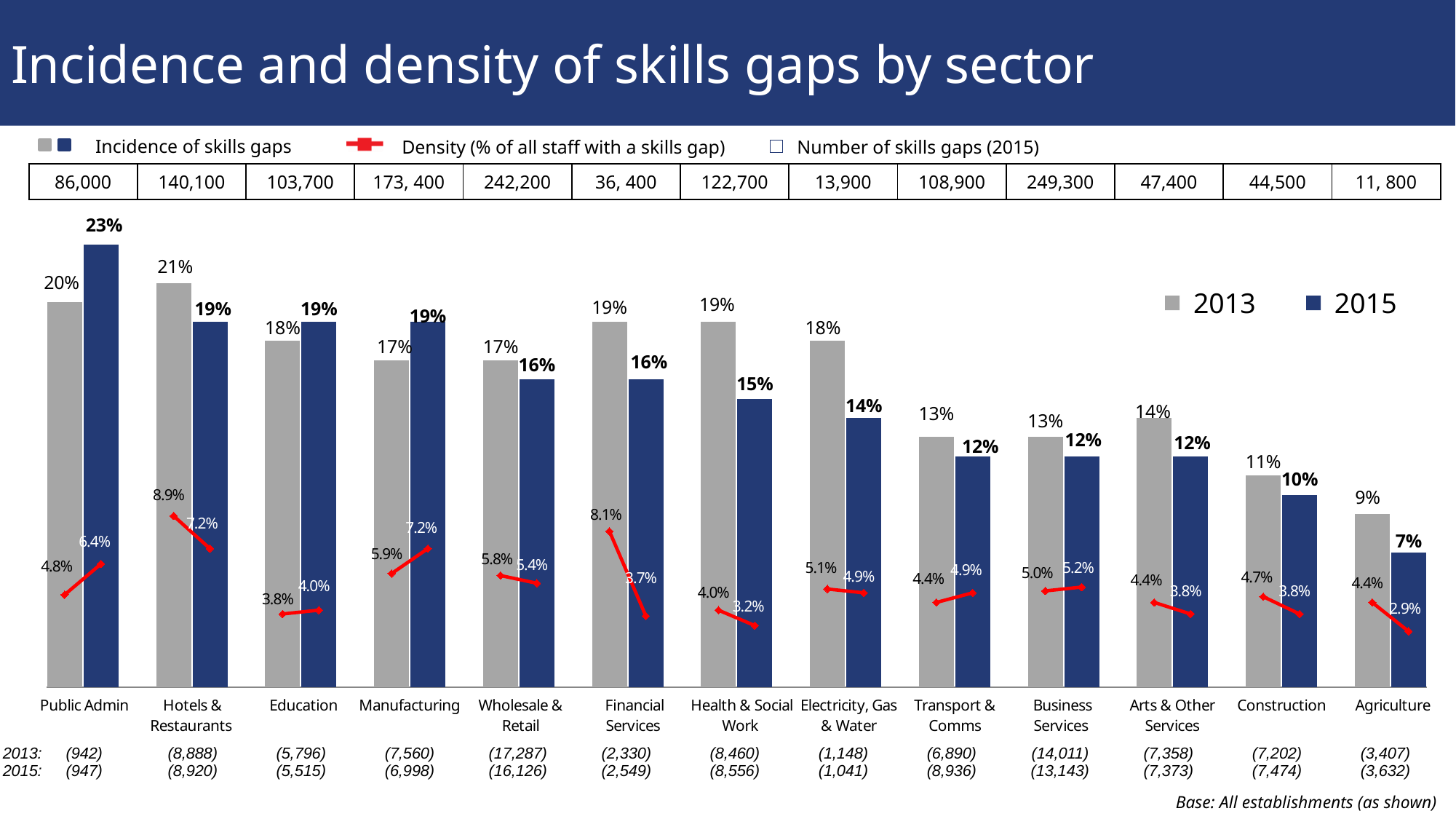
Which sector has the highest incidence of skills gaps in 2015? Public Admin How many years does the bar legend list? 2 Which sector has the highest incidence of skills gaps in 2013? Hotels & Restaurants Which sector has the lowest incidence of skills gaps in 2015? Agriculture What is the incidence of skills gaps for Public Admin in 2015? 23% By how many percentage points did the incidence of skills gaps in Financial Services change from 2013 (19%) to 2015 (16%)? 3 percentage points How many sectors are shown on the x axis of the chart? 13 What is the number of skills gaps (2015) shown for Business Services? 249,300 What kind of chart is used to show the incidence of skills gaps? Bar chart Do the 2015 incidence values generally rise or fall moving from left to right across the sectors? Fall Which is larger: the 2015 incidence of skills gaps for Manufacturing or for Wholesale & Retail? Manufacturing What is the density of skills gaps for Hotels & Restaurants in 2013? 8.9%